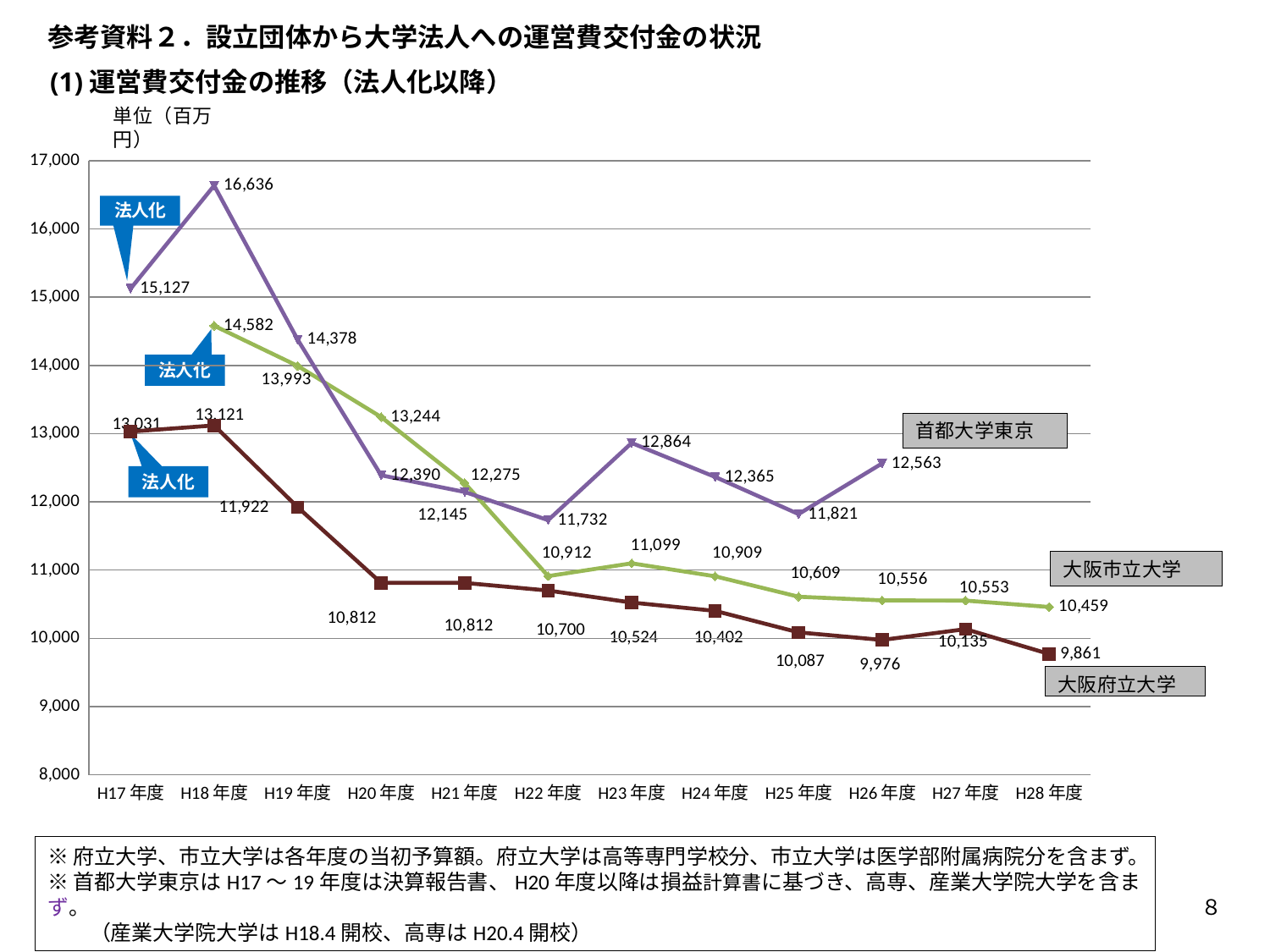
What is the value for 大阪市立大学 in H22年度? 10,912 What is the difference between the 大阪市立大学 values for H27年度 and H28年度? 94 What is the difference between the 首都大学東京 values for H18年度 and H17年度? 1,509 In which year does 首都大学東京 reach its highest value? H18年度 How many fiscal years are shown on the x axis? 12 What kind of chart is shown on the slide? line chart How many universities (lines) are plotted on the chart? 3 What is the value for 首都大学東京 in H18年度? 16,636 Is the value for 首都大学東京 in H25年度 greater or less than 12,000? less In H23年度, which is larger: 大阪市立大学 or 大阪府立大学? 大阪市立大学 What is the value for 大阪府立大学 in H28年度? 9,861 In which year does 大阪府立大学 have its lowest value? H28年度